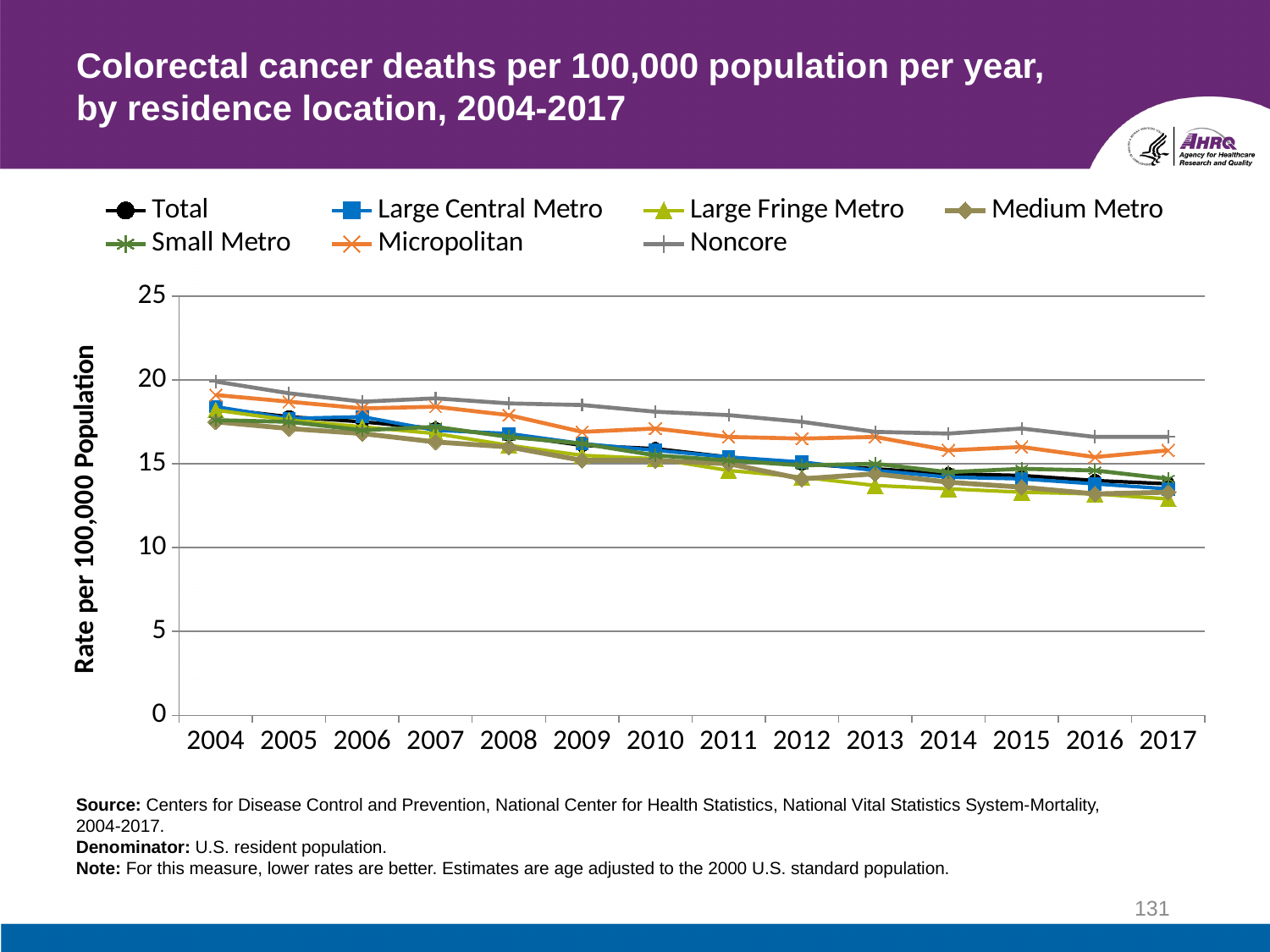
Which residence location has the highest rate in 2004? Noncore Is the value for Noncore in 2004 greater or less than 15? greater Which residence location has the highest rate in 2017? Noncore What is the label on the y axis? Rate per 100,000 Population What kind of chart is shown on the slide? line chart In 2004, which is larger: the rate for Noncore or the rate for Large Fringe Metro? Noncore Is the value for Large Fringe Metro in 2017 greater or less than 15? less How many series does the legend list? 7 Is the value for Noncore in 2017 greater or less than 15? greater How many years are plotted along the x axis? 14 Do the colorectal cancer death rates generally rise or fall from 2004 to 2017? fall